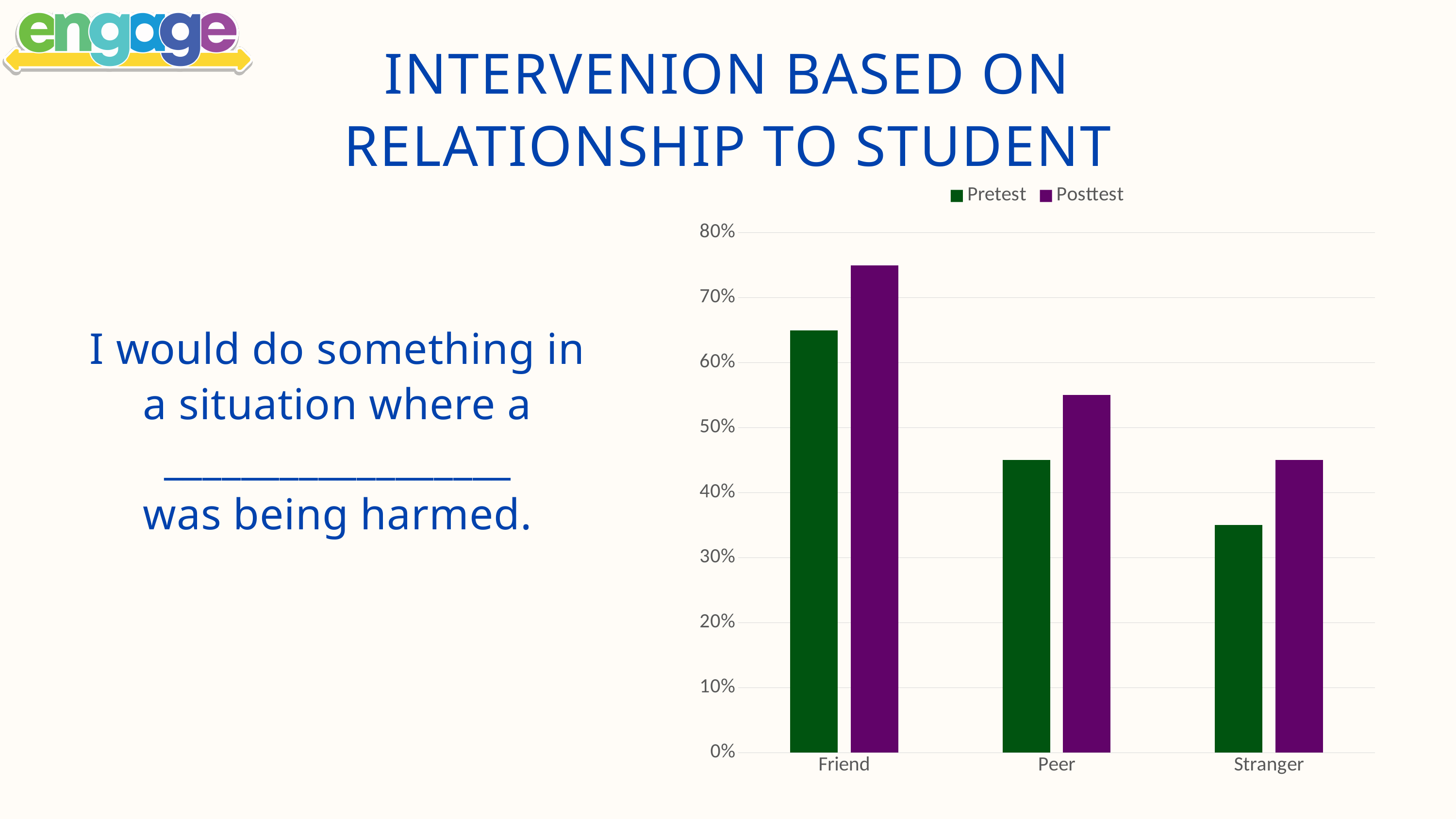
Which is larger for Peer, the Pretest value or the Posttest value? Posttest What colour are the Posttest bars? purple How many categories are shown on the x axis? 3 Which is larger, the Pretest value for Friend or the Pretest value for Peer? Friend How many series does the legend list? 2 Is the Pretest value for Friend greater or less than 60%? greater Which category has the lowest Pretest value? Stranger What kind of chart is shown on the slide? bar chart Which category has the highest Posttest value? Friend Is the Posttest value for Friend greater or less than 70%? greater Is the Pretest value for Stranger greater or less than 40%? less